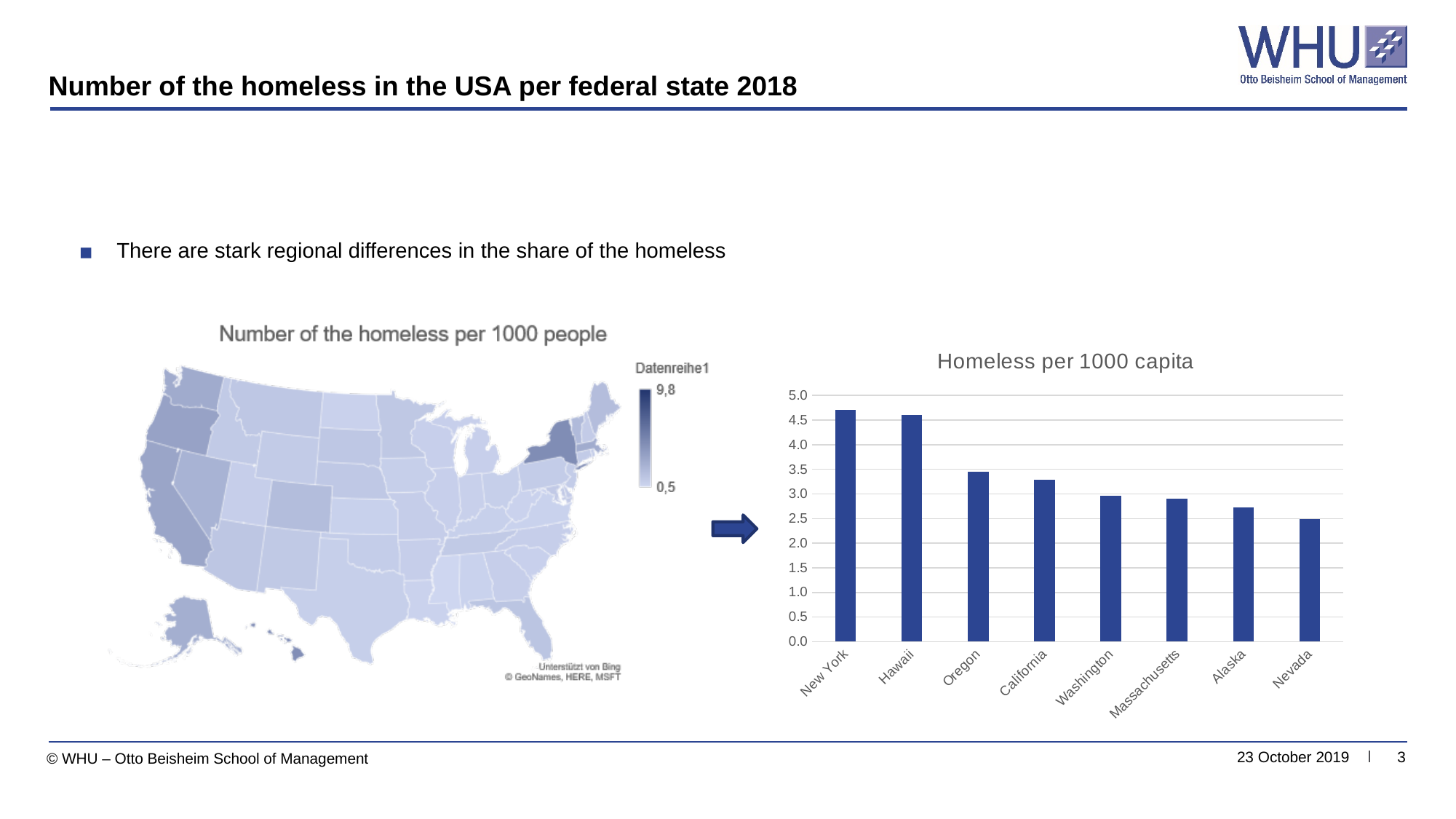
On the map chart "Number of the homeless per 1000 people", what are the maximum and minimum values shown on the colour legend? 9,8 and 0,5 In the bar chart "Homeless per 1000 capita", is the value for Oregon greater or less than 3.0? greater In the bar chart "Homeless per 1000 capita", do the values rise or fall from left to right along the x axis? fall In the bar chart "Homeless per 1000 capita", is the value for New York greater or less than 4.5? greater In the bar chart "Homeless per 1000 capita", which has the larger value, Oregon or Nevada? Oregon What kind of chart is the chart titled "Homeless per 1000 capita"? bar chart In the bar chart "Homeless per 1000 capita", is the value for Massachusetts greater or less than 3.0? less How many states are shown in the bar chart "Homeless per 1000 capita"? 8 In the bar chart "Homeless per 1000 capita", which state has the lowest value? Nevada In the bar chart "Homeless per 1000 capita", which has the larger value, New York or California? New York